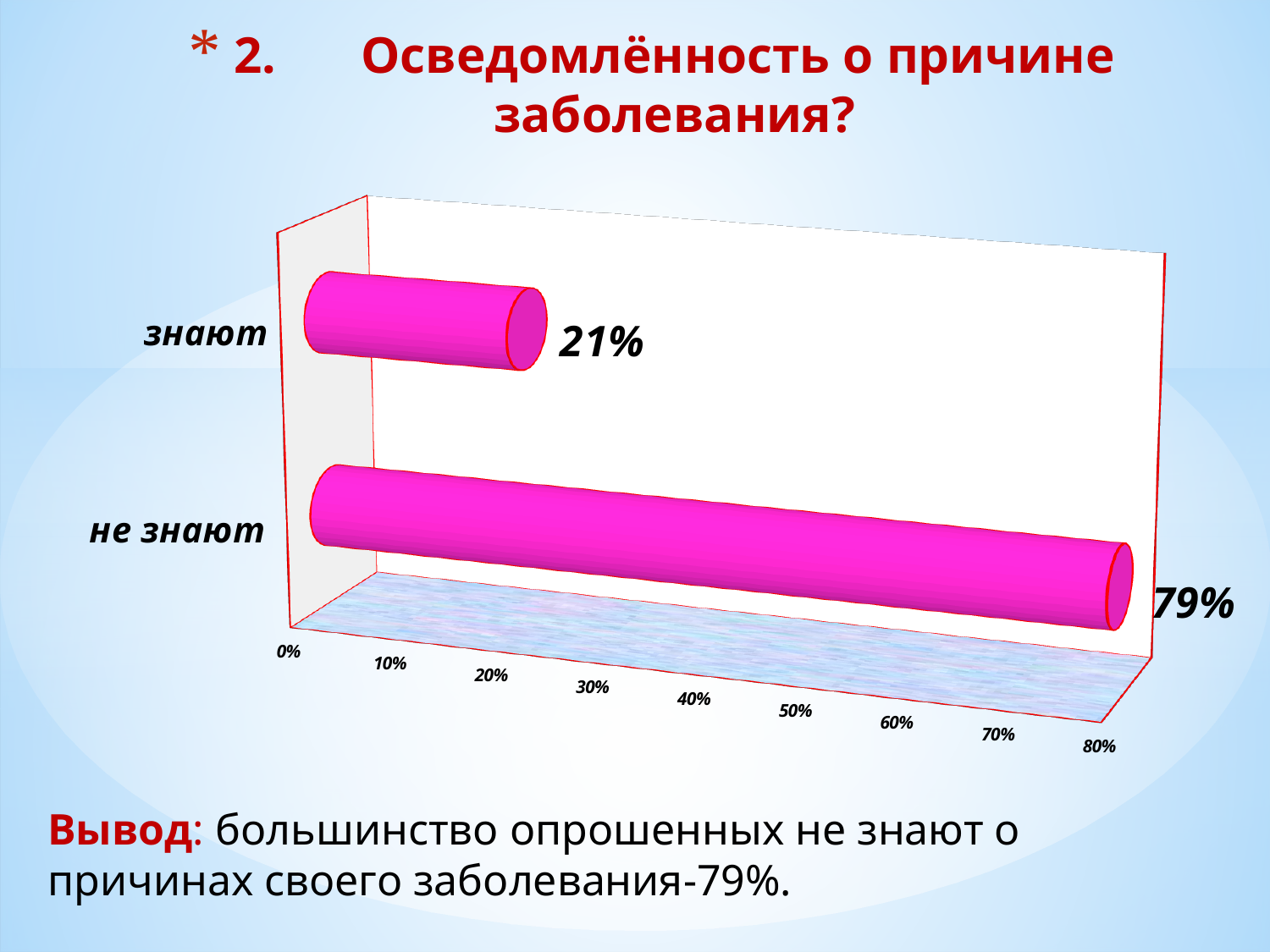
What colour are the bars in the chart? magenta (pink) What is the difference between the values for "не знают" and "знают"? 58% What is the value for "знают"? 21% How many categories are shown in the chart? 2 What kind of chart is shown on the slide? bar chart Is the value for "знают" greater or less than 30%? less Is the value for "не знают" greater or less than 50%? greater Which category has the lowest value? знают What is the value for "не знают"? 79% Which category has the highest value? не знают What is the highest value shown on the percentage axis? 80% Which is larger, the value for "знают" or the value for "не знают"? не знают